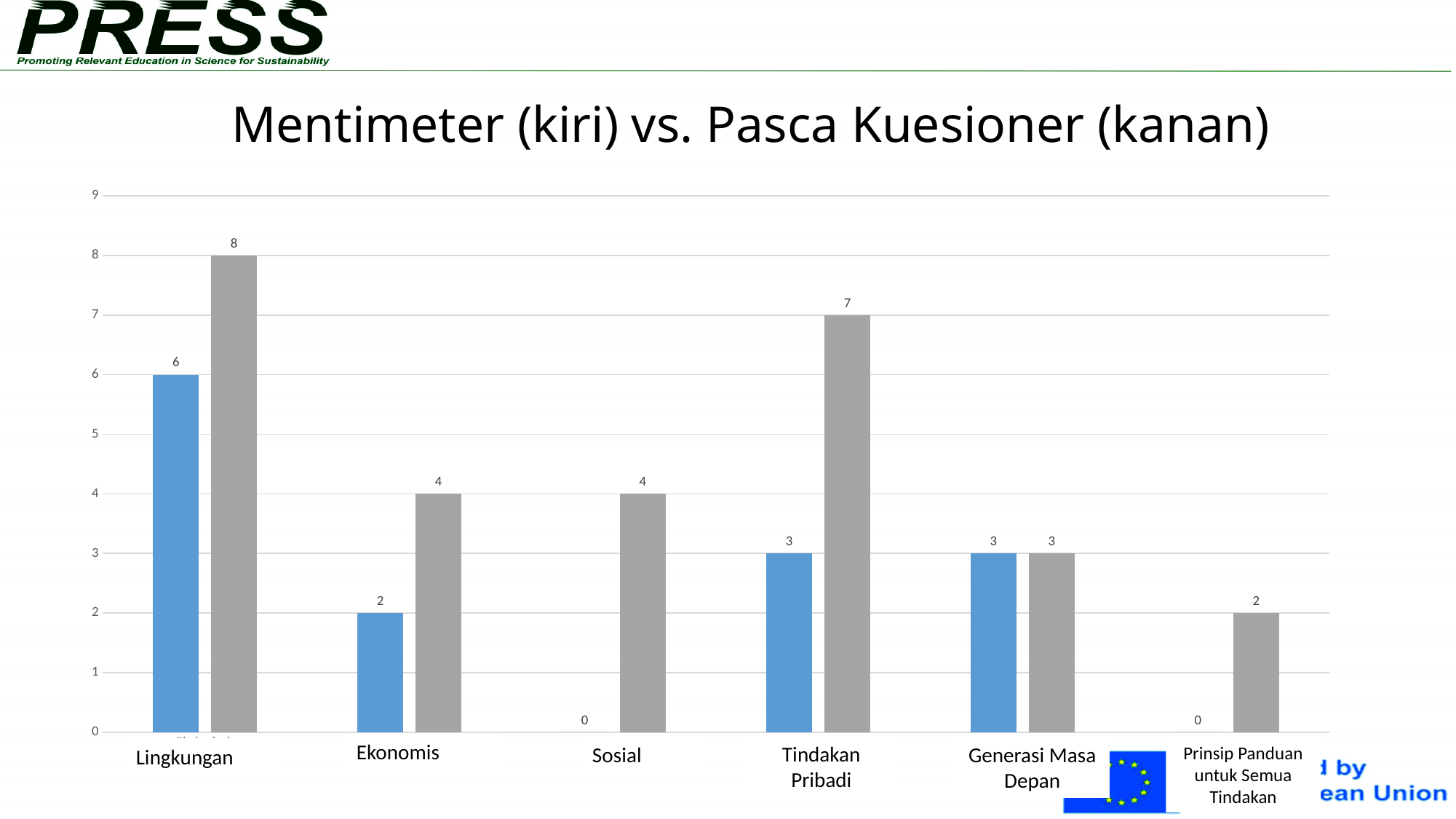
Which category has the lowest Pasca Kuesioner (right bar) value? Prinsip Panduan untuk Semua Tindakan How many categories are shown on the x axis? 6 Which is larger for Ekonomis: the Mentimeter value or the Pasca Kuesioner value? Pasca Kuesioner What is the difference between the Pasca Kuesioner and Mentimeter values for Lingkungan? 2 What is the Mentimeter (left bar) value for Lingkungan? 6 Which category has the highest Pasca Kuesioner (right bar) value? Lingkungan What is the Pasca Kuesioner (right bar) value for Sosial? 4 What is the title of the chart? Mentimeter (kiri) vs. Pasca Kuesioner (kanan) What is the Pasca Kuesioner (right bar) value for Tindakan Pribadi? 7 What is the difference between the Pasca Kuesioner and Mentimeter values for Tindakan Pribadi? 4 What kind of chart is shown on the slide? Bar chart What is the Mentimeter (left bar) value for Prinsip Panduan untuk Semua Tindakan? 0